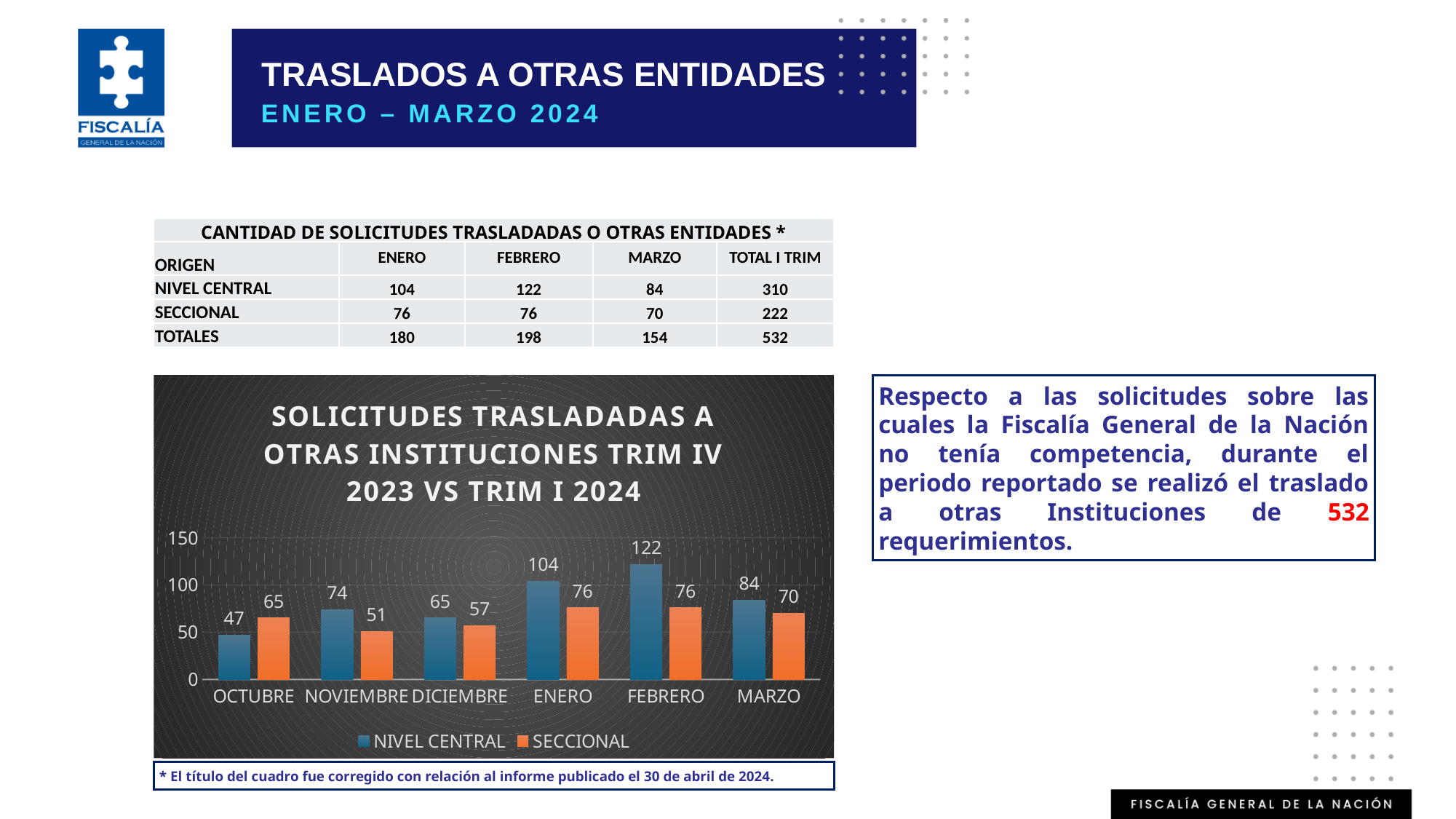
How many series does the chart legend list? 2 How many months are shown on the x axis of the chart? 6 Is the value for NIVEL CENTRAL in FEBRERO greater or less than 100? greater What is the value for NIVEL CENTRAL in DICIEMBRE? 65 What is the difference between the NIVEL CENTRAL and SECCIONAL values in ENERO? 28 Which month has the lowest NIVEL CENTRAL value? OCTUBRE Which month has the highest NIVEL CENTRAL value? FEBRERO What kind of chart is shown on the slide? Bar chart In NOVIEMBRE, which series is larger, NIVEL CENTRAL or SECCIONAL? NIVEL CENTRAL What is the value for SECCIONAL in OCTUBRE? 65 Which colour represents SECCIONAL in the chart? Orange What is the value for NIVEL CENTRAL in FEBRERO? 122